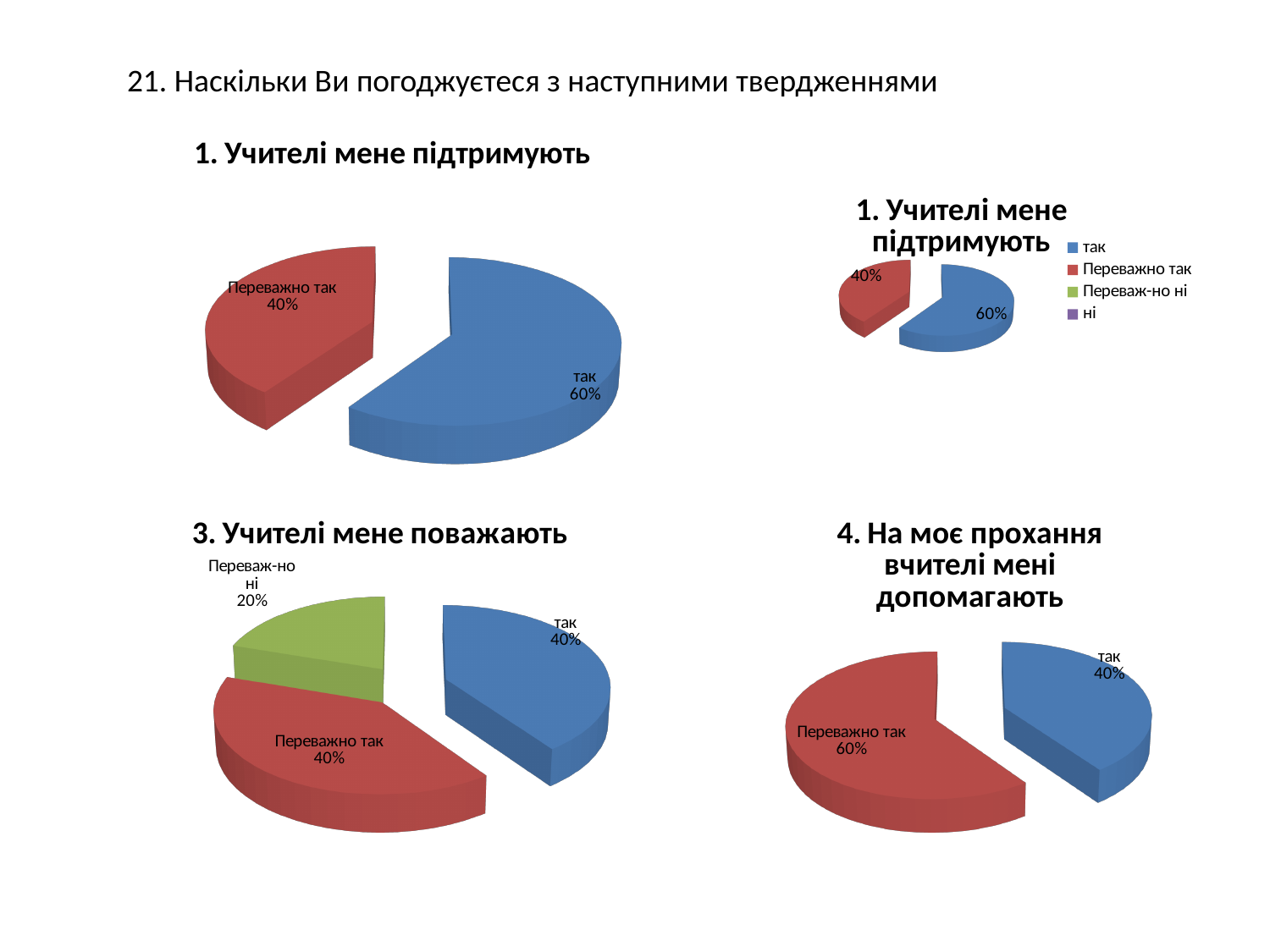
In the top-left chart "1. Учителі мене підтримують", what share is labelled "Переважно так"? 40% In the top-left chart "1. Учителі мене підтримують", which slice is the largest? так What kind of chart is the bottom-left chart "3. Учителі мене поважають"? pie chart In the bottom-right chart "4. На моє прохання вчителі мені допомагають", what share is labelled "Переважно так"? 60% In the top-left chart "1. Учителі мене підтримують", what colour is the "так" slice? blue In the top-left chart "1. Учителі мене підтримують", what share is labelled "так"? 60% In the bottom-left chart "3. Учителі мене поважають", what is the difference between the "так" share and the "Переваж-но ні" share? 20% In the bottom-left chart "3. Учителі мене поважають", what share is labelled "Переваж-но ні"? 20% How many entries does the legend of the small top-right chart "1. Учителі мене підтримують" list? 4 In the bottom-left chart "3. Учителі мене поважають", which slice is the smallest? Переваж-но ні How many slices does the bottom-left chart "3. Учителі мене поважають" have? 3 In the bottom-right chart "4. На моє прохання вчителі мені допомагають", which is larger, "так" or "Переважно так"? Переважно так